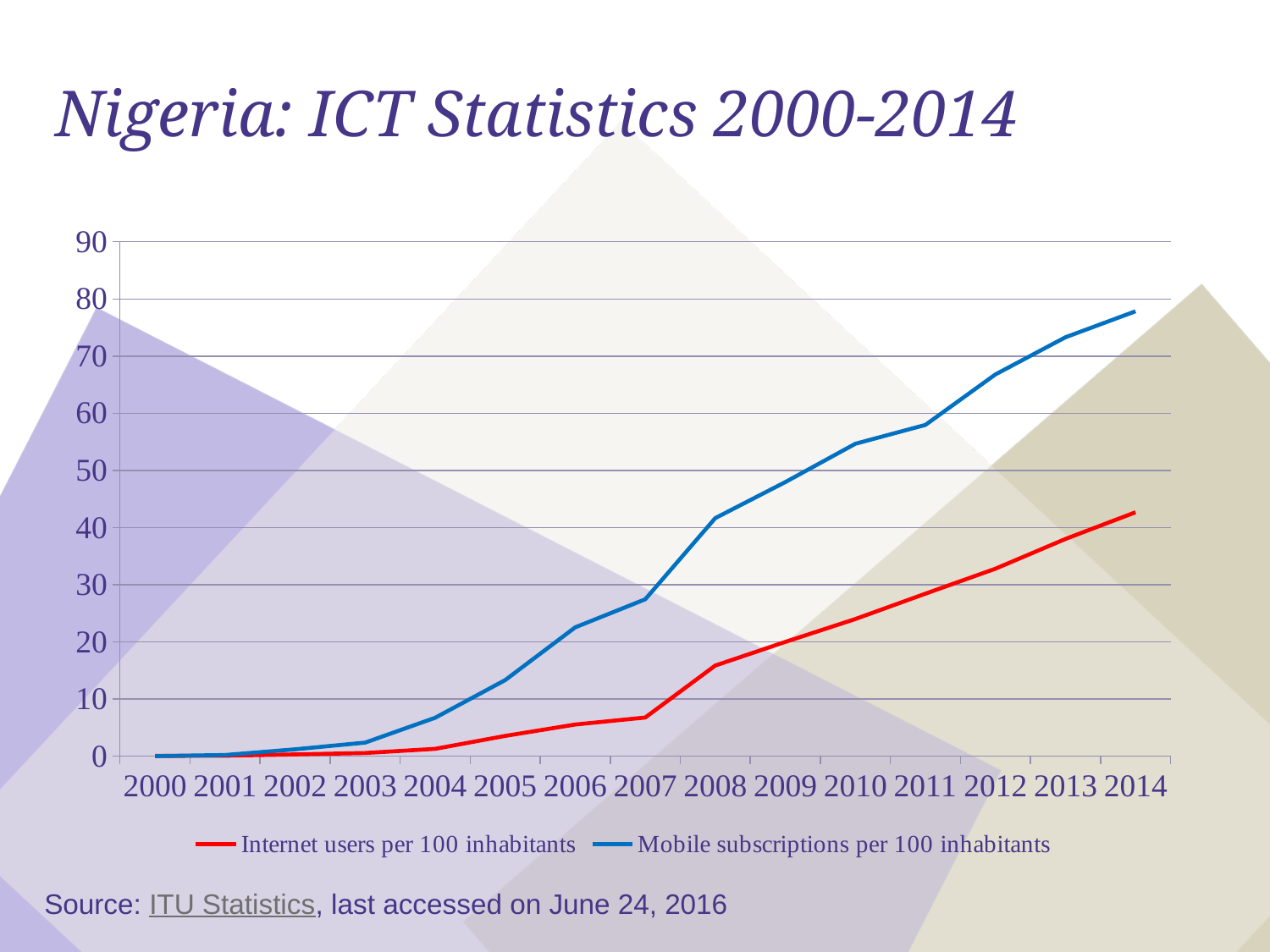
How many series does the legend list? 2 What kind of chart is shown on the slide? line chart In 2014, which series has the larger value: Internet users per 100 inhabitants or Mobile subscriptions per 100 inhabitants? Mobile subscriptions per 100 inhabitants Is the value for Mobile subscriptions per 100 inhabitants in 2014 greater or less than 70? greater How many years are shown on the x axis? 15 In which year is the value for Internet users per 100 inhabitants lowest? 2000 Is the value for Internet users per 100 inhabitants in 2014 greater or less than 40? greater In which year is the value for Mobile subscriptions per 100 inhabitants highest? 2014 Is the value for Internet users per 100 inhabitants in 2008 greater or less than 20? less Do the values for Mobile subscriptions per 100 inhabitants rise or fall from 2000 to 2014? rise What is the title of the slide containing the chart? Nigeria: ICT Statistics 2000-2014